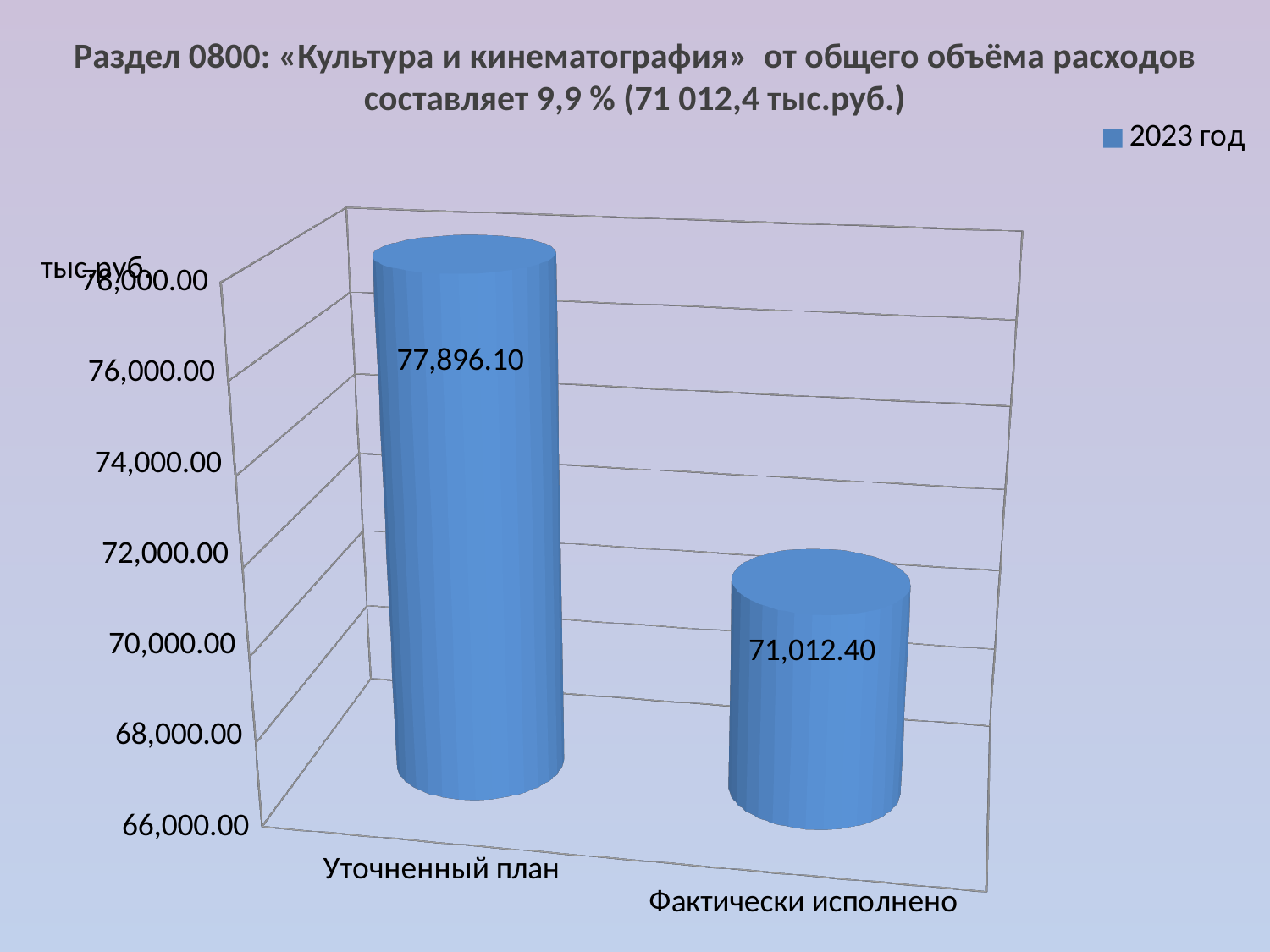
Is the value for «Фактически исполнено» greater or less than 72,000.00? less Which category has the highest value? Уточненный план What kind of chart is shown on the slide? bar chart How many series does the legend list? 1 Which is larger, the value for «Уточненный план» or for «Фактически исполнено»? Уточненный план How many categories are shown on the chart? 2 What is the difference between the values for «Уточненный план» and «Фактически исполнено»? 6,883.70 Which category has the lowest value? Фактически исполнено What series name is shown in the chart legend? 2023 год What is the value for «Фактически исполнено»? 71,012.40 What is the value for «Уточненный план»? 77,896.10 Is the value for «Уточненный план» greater or less than 76,000.00? greater